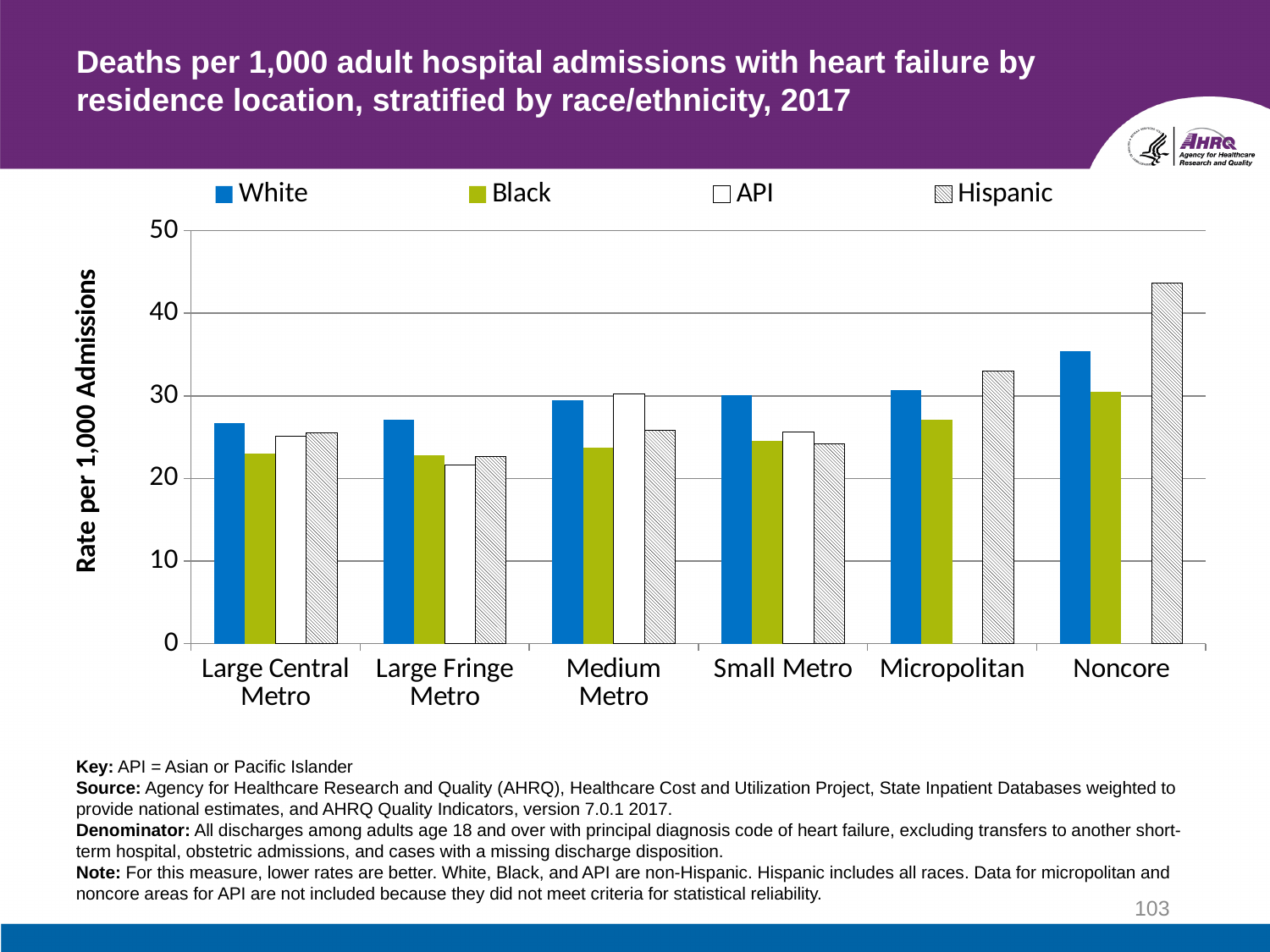
Which series and residence location has the highest bar in the chart? Hispanic, Noncore For Noncore, which is larger, the White value or the Black value? White Is the Hispanic value for Noncore greater or less than 40? greater For Small Metro, which is larger, the White value or the Hispanic value? White What kind of chart is shown on the slide? Bar chart Which residence locations have no API bar shown? Micropolitan and Noncore Do the White values rise or fall moving from Large Central Metro to Noncore along the x axis? rise How many residence location categories are shown on the x axis? 6 How many series does the legend list? 4 Is the Black value for Micropolitan greater or less than 30? less Which residence location has the highest Black value? Noncore Is the White value for Large Central Metro greater or less than 30? less